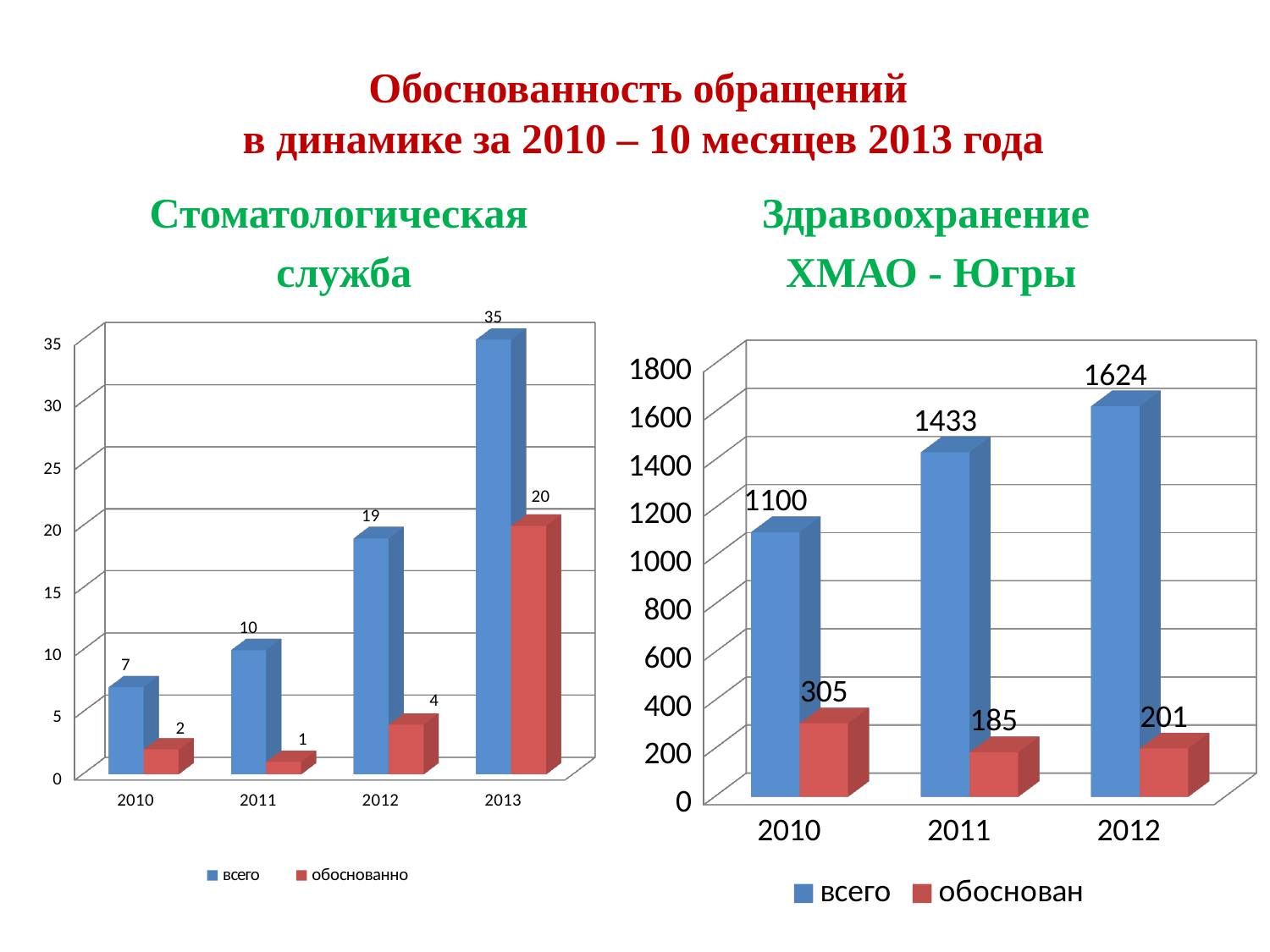
In the right chart (Здравоохранение ХМАО - Югры), what is the difference between всего in 2012 and всего in 2010? 524 In the right chart (Здравоохранение ХМАО - Югры), which is larger: обоснован in 2011 or обоснован in 2012? 2012 In the left chart (Стоматологическая служба), what is the difference between всего and обоснованно in 2013? 15 In the left chart (Стоматологическая служба), what is the value of всего for 2013? 35 In the right chart (Здравоохранение ХМАО - Югры), which year has the highest всего value? 2012 In the left chart (Стоматологическая служба), how many years are shown on the x axis? 4 In the right chart (Здравоохранение ХМАО - Югры), what is the value of всего for 2011? 1433 In the right chart (Здравоохранение ХМАО - Югры), what is the value of обоснован for 2010? 305 In the left chart (Стоматологическая служба), which year has the lowest обоснованно value? 2011 How many series does the legend of the right chart (Здравоохранение ХМАО - Югры) list? 2 In the left chart (Стоматологическая служба), what is the value of обоснованно for 2012? 4 In the left chart (Стоматологическая служба), does the всего value rise or fall from 2010 to 2013? rise